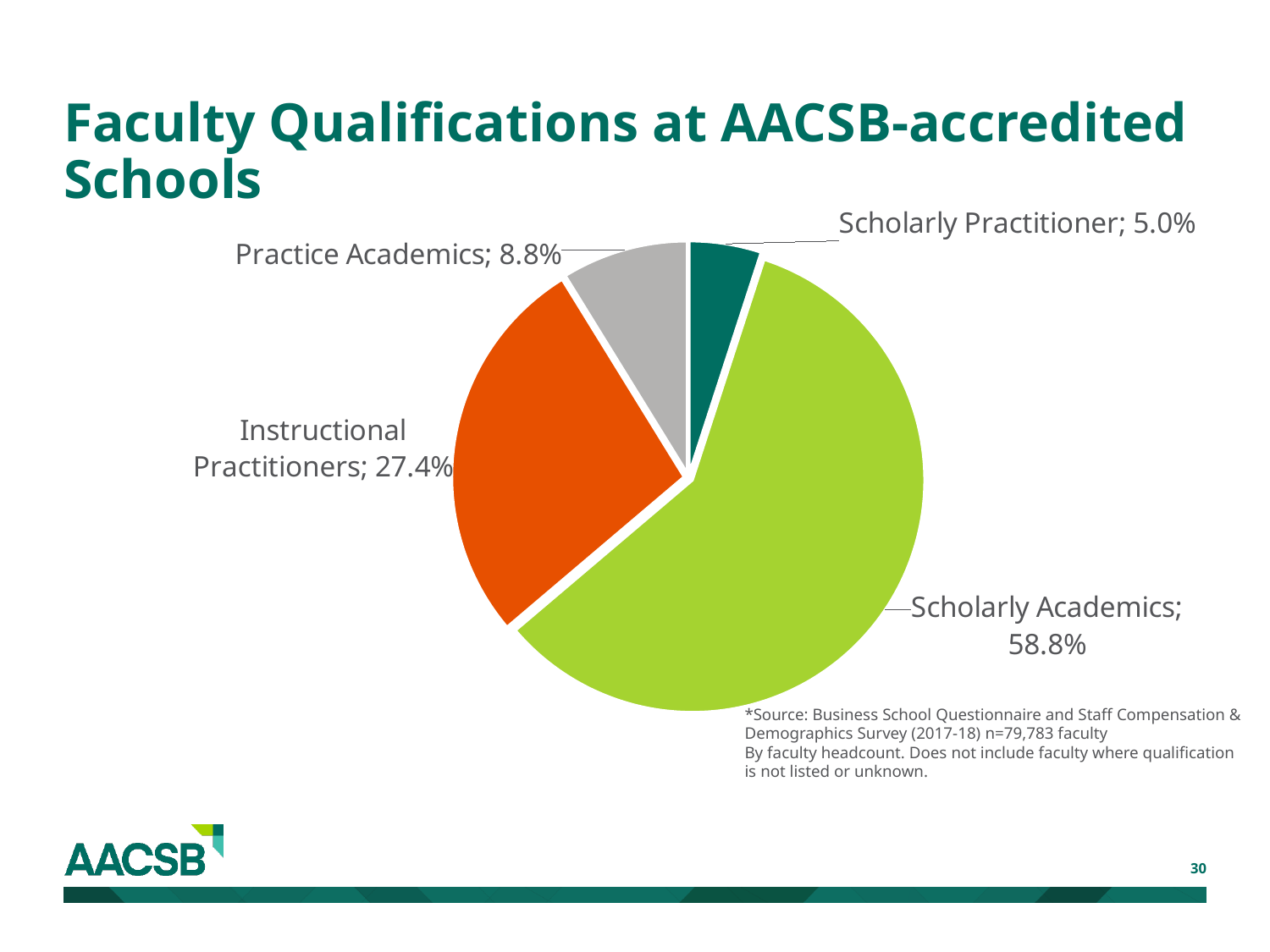
What is the title of the slide containing the pie chart? Faculty Qualifications at AACSB-accredited Schools What share of faculty are Instructional Practitioners? 27.4% What is the difference in percentage points between Scholarly Academics and Instructional Practitioners? 31.4 What is the combined share of Practice Academics and Scholarly Practitioners? 13.8% Which faculty qualification category has the largest share? Scholarly Academics How many slices does the pie chart have? 4 Which is larger, the share of Practice Academics or the share of Scholarly Practitioners? Practice Academics What share of faculty are Scholarly Academics? 58.8% What share of faculty are Scholarly Practitioners? 5.0% Which faculty qualification category has the smallest share? Scholarly Practitioner What share of faculty are Practice Academics? 8.8% What kind of chart is shown on the slide? pie chart